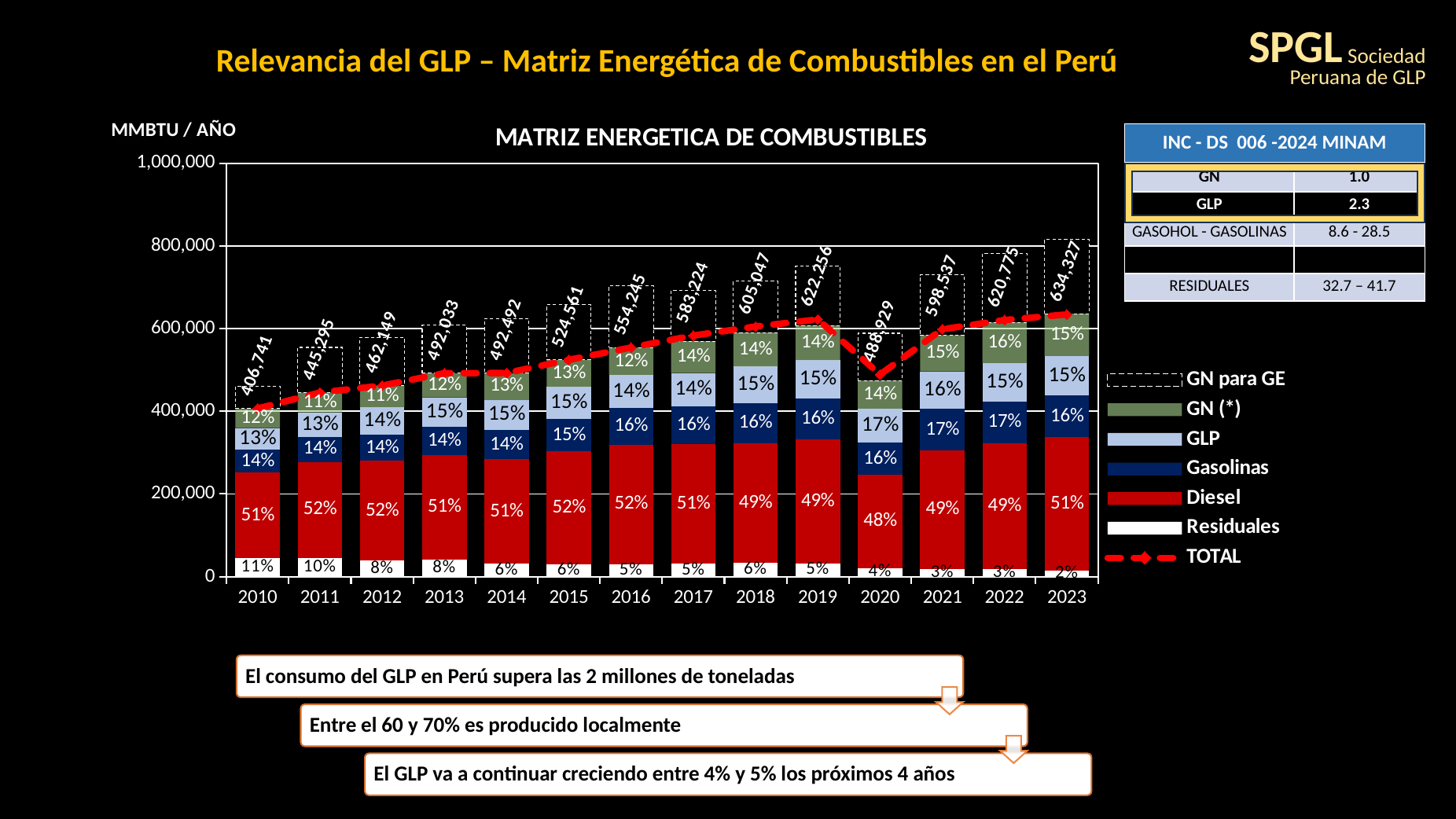
How many years are shown on the x axis? 14 What is the difference between the TOTAL values for 2023 and 2022? 13,552 Which year has a larger TOTAL value, 2019 or 2020? 2019 Is the TOTAL value for 2020 greater or less than 600,000? less What percentage share does Diesel have in 2020? 48% Which year has the highest TOTAL value? 2023 What percentage share does GLP have in 2020? 17% What is the TOTAL value labelled for 2023? 634,327 Which year has the lowest TOTAL value? 2010 What percentage share does Residuales have in 2010? 11% What kind of chart is shown? Combination chart: stacked bar chart with a line (TOTAL) How many entries does the legend list? 7